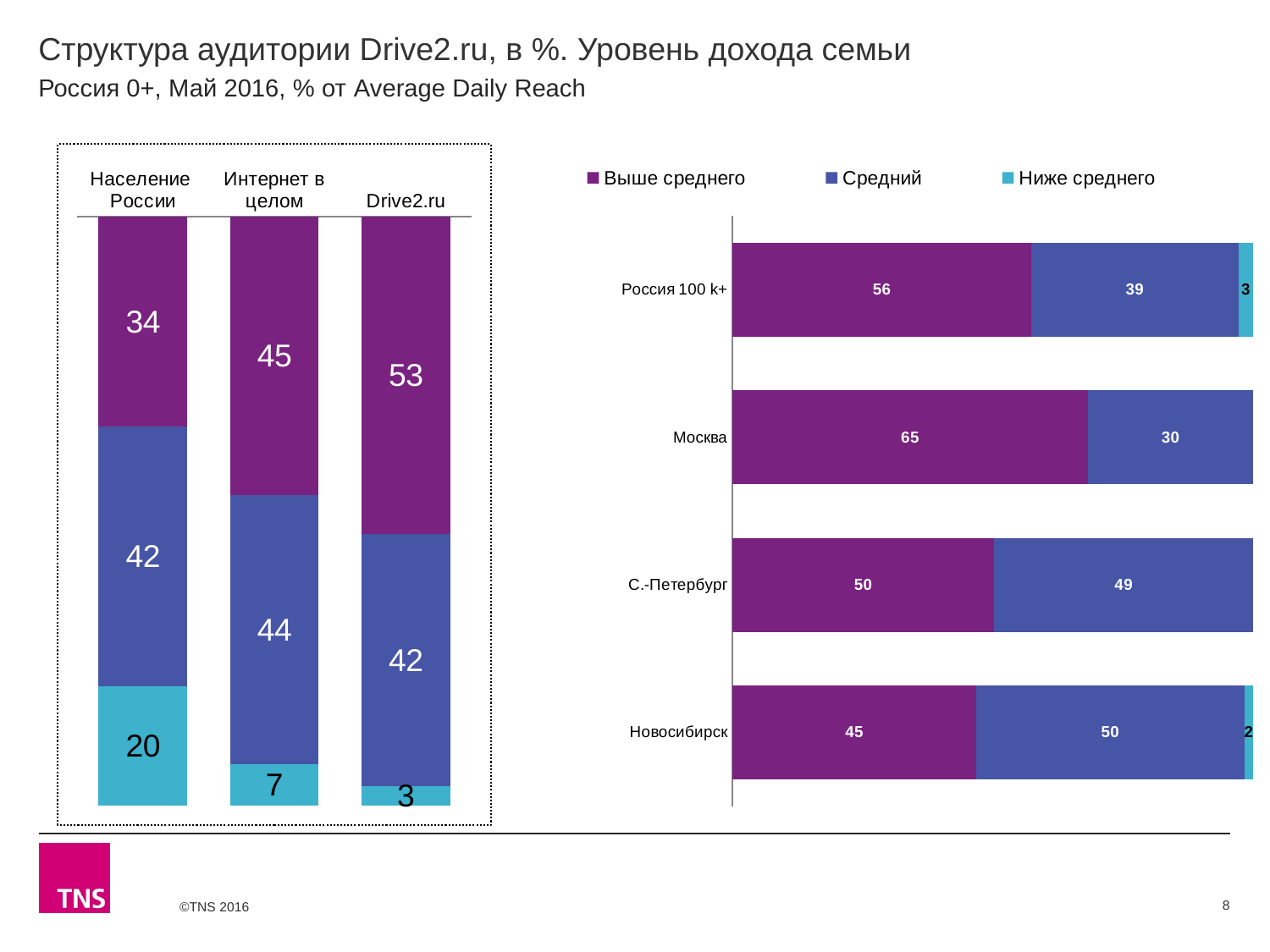
In the left chart, what is the difference between the bottom (light blue) segments of Население России and Drive2.ru? 17 In the left chart, what is the value of the top (purple) segment for Drive2.ru? 53 In the left chart, which category has the largest top (purple) segment? Drive2.ru In the left chart, how many categories are shown? 3 In the left chart, what is the value of the bottom (light blue) segment for Население России? 20 In the right chart, what is the value of Выше среднего for Москва? 65 In the left chart, what is the value of the middle (blue) segment for Интернет в целом? 44 In the right chart, which is larger for Новосибирск: Выше среднего or Средний? Средний In the right chart, what is the value of Средний for С.-Петербург? 49 What type of chart is the right chart? Stacked bar chart In the right chart, how many series does the legend list? 3 In the right chart, which category has the highest value for Выше среднего? Москва